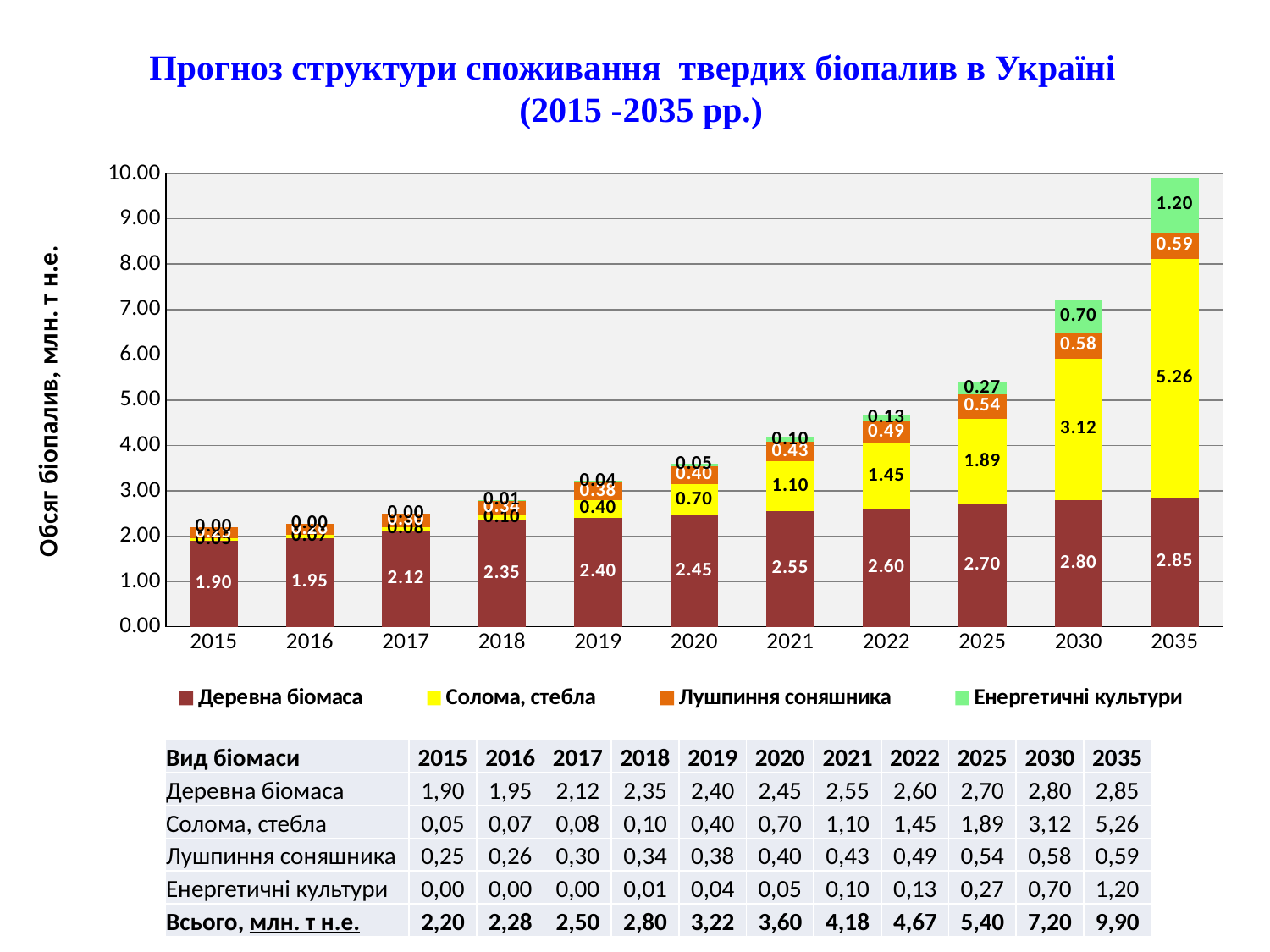
What kind of chart is shown on the slide? stacked bar chart Do the values of Деревна біомаса rise or fall from 2015 to 2035? rise In which year is the value of Солома, стебла the highest? 2035 What is the total of the stacked bar for 2035? 9.90 For 2030, which is larger: Солома, стебла or Деревна біомаса? Солома, стебла What is the value of Енергетичні культури for 2025? 0.27 What is the value of Солома, стебла for 2030? 3.12 How many years are shown along the x axis of the chart? 11 What is the difference between the Деревна біомаса values for 2035 and 2015? 0.95 What is the label of the vertical axis? Обсяг біопалив, млн. т н.е. What is the value of Деревна біомаса for 2035? 2.85 How many series does the legend list? 4